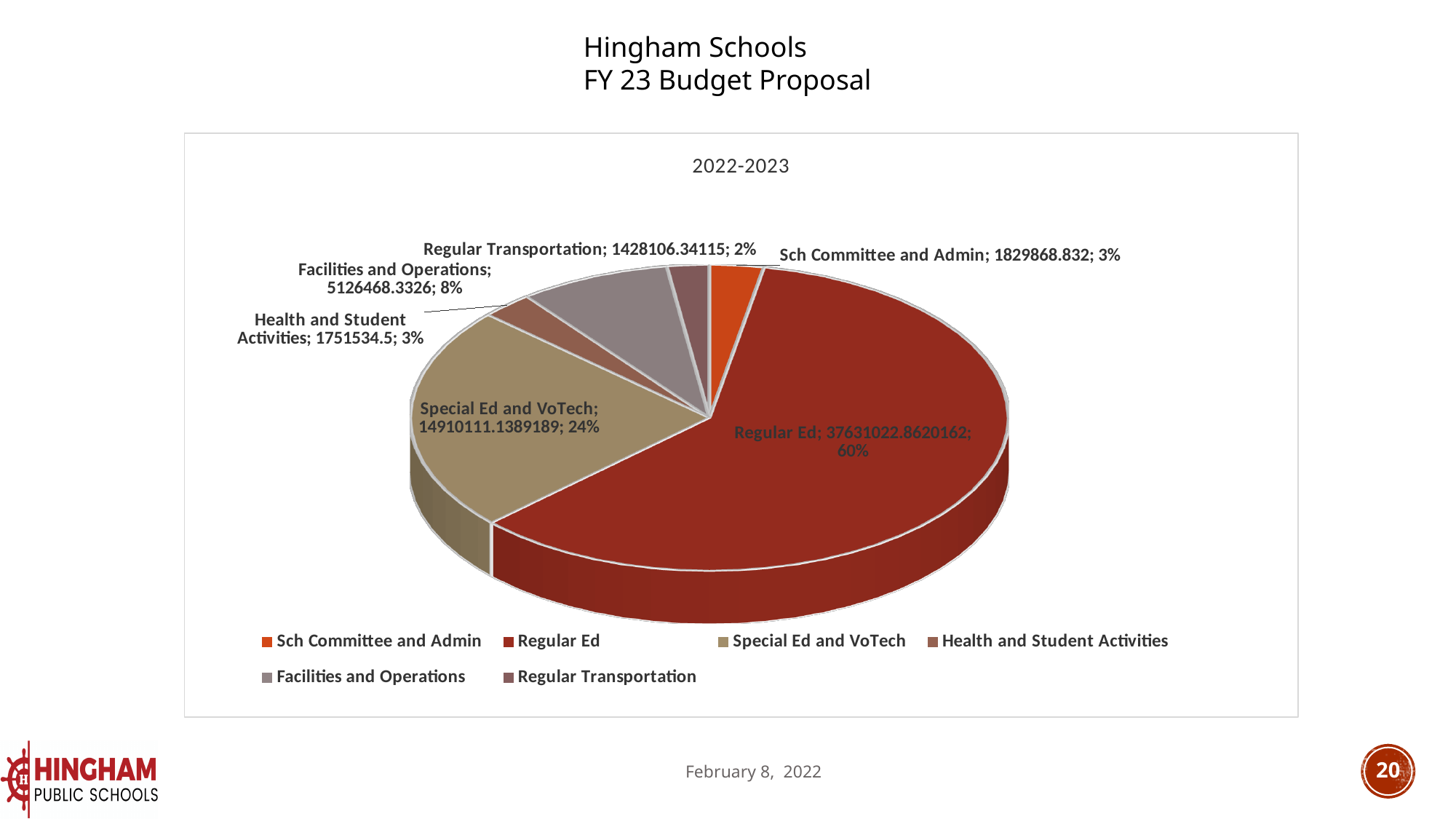
Which category has the largest slice of the pie? Regular Ed What share of the pie does Regular Ed represent? 60% What is the chart's title? 2022-2023 How many categories does the pie chart have? 6 What share of the pie does Special Ed and VoTech represent? 24% What is the value shown for Health and Student Activities? 1751534.5 What is the difference in percentage points between the Regular Ed share and the Special Ed and VoTech share? 36% What is the value shown for Regular Transportation? 1428106.34115 What kind of chart is shown on the slide? pie chart What is the value shown for Facilities and Operations? 5126468.3326 Which is larger, the slice for Facilities and Operations or the slice for Health and Student Activities? Facilities and Operations Which category has the smallest slice of the pie? Regular Transportation